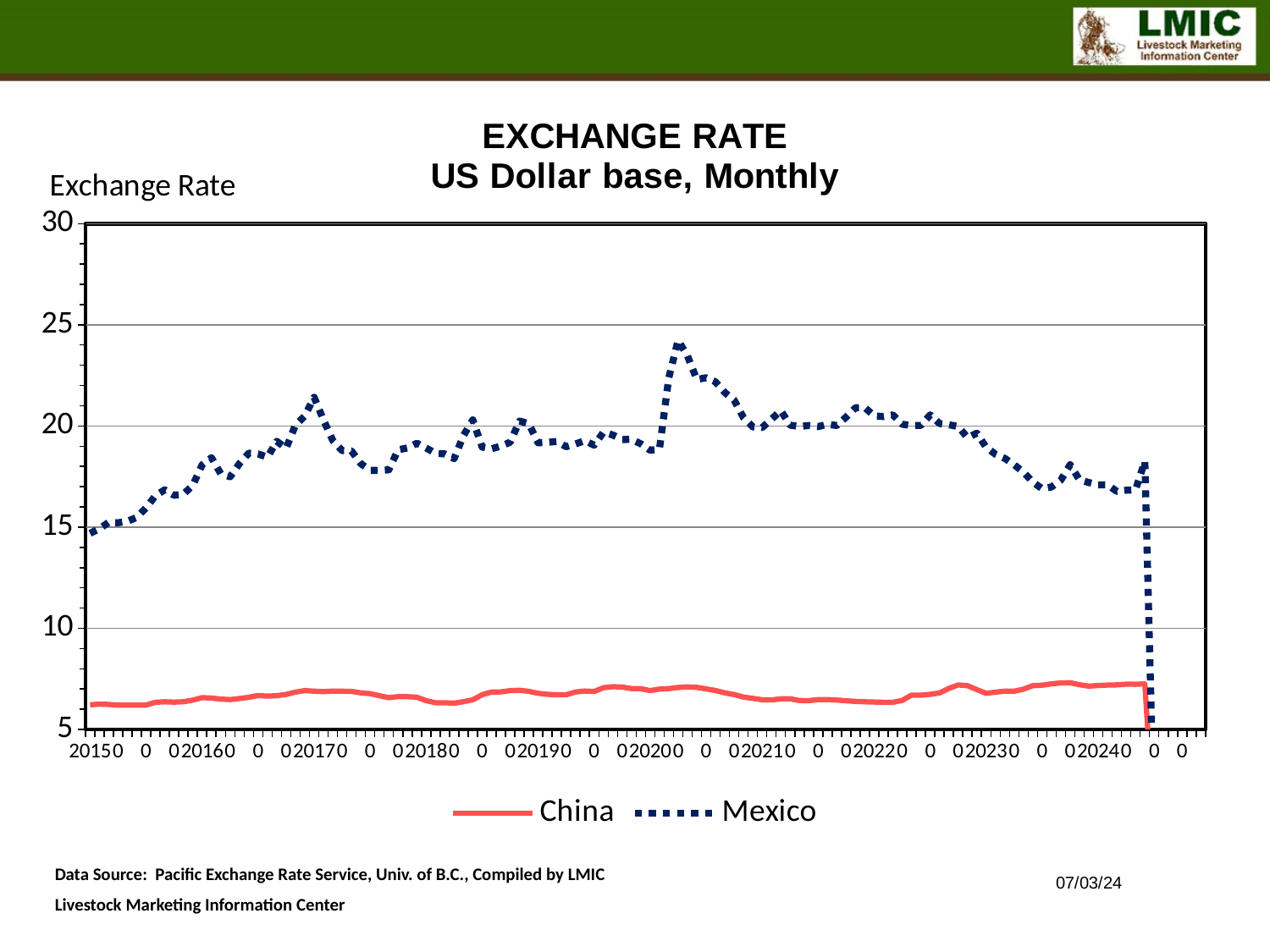
What is the highest value shown on the vertical axis? 30 What is the title of the chart? EXCHANGE RATE US Dollar base, Monthly Does the China series ever rise above 10 on the chart? No Which series has the higher exchange rate throughout the chart, China or Mexico? Mexico How many series does the legend list? 2 Is the value for Mexico around 2020 greater or less than 15? greater What kind of chart is shown on the slide? line chart Does the Mexico series rise or fall from 2015 to its peak around 2020? rise Is the value for Mexico at the start of the series (2015) greater or less than 20? less Which two series are listed in the chart legend? China and Mexico